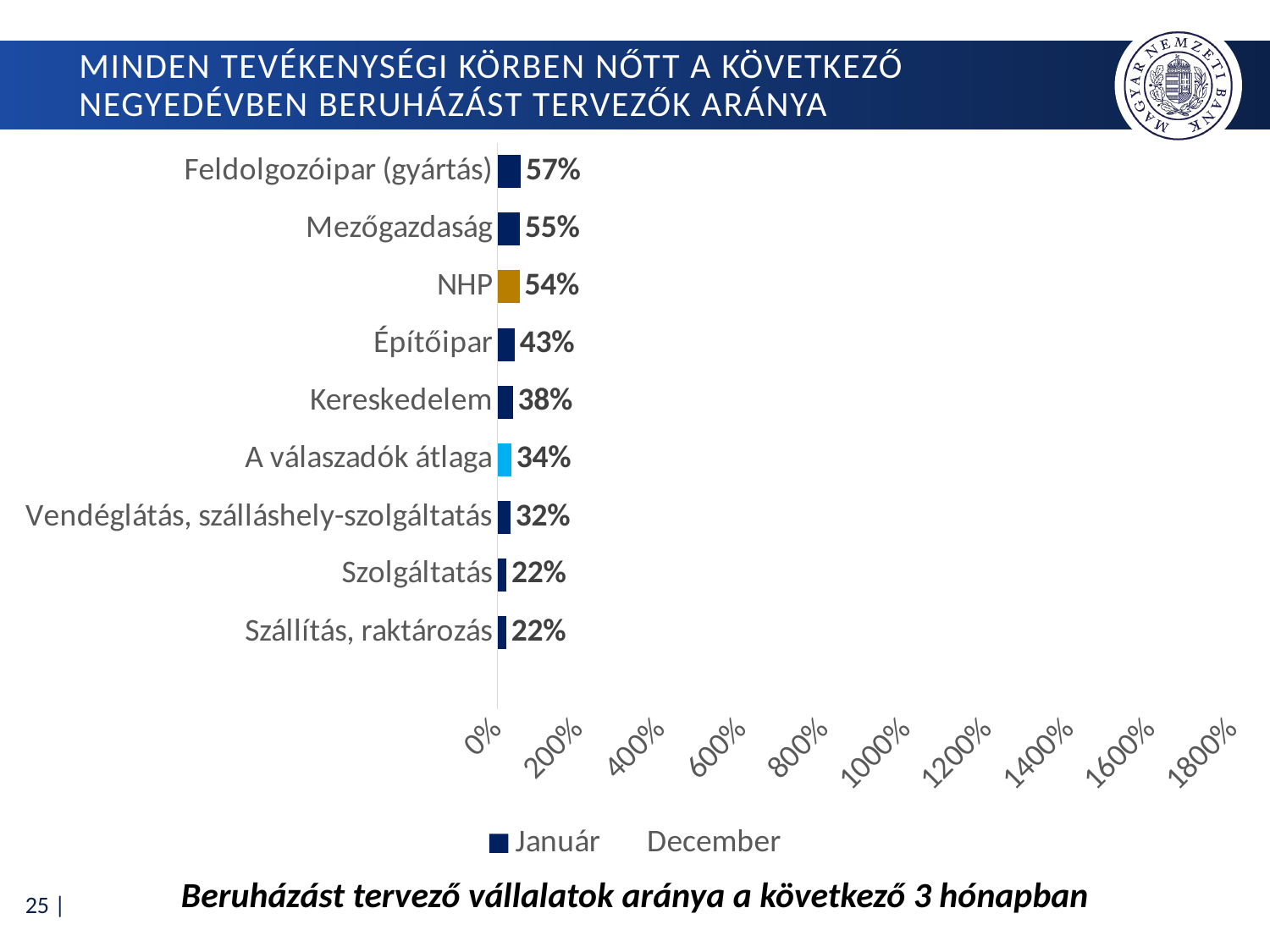
What is the difference between the values for Feldolgozóipar (gyártás) and Kereskedelem? 19 percentage points What is the value shown for Vendéglátás, szálláshely-szolgáltatás? 32% How many series does the legend list? 2 Which has a larger value, Mezőgazdaság or Építőipar? Mezőgazdaság What is the value shown for A válaszadók átlaga? 34% What is the caption printed below the chart? Beruházást tervező vállalatok aránya a következő 3 hónapban How many categories are shown on the chart? 9 What is the value shown for NHP? 54% What are the two series named in the legend? Január and December What kind of chart is shown on the slide? Bar chart What is the value shown for Feldolgozóipar (gyártás)? 57% Which category has the highest value? Feldolgozóipar (gyártás)